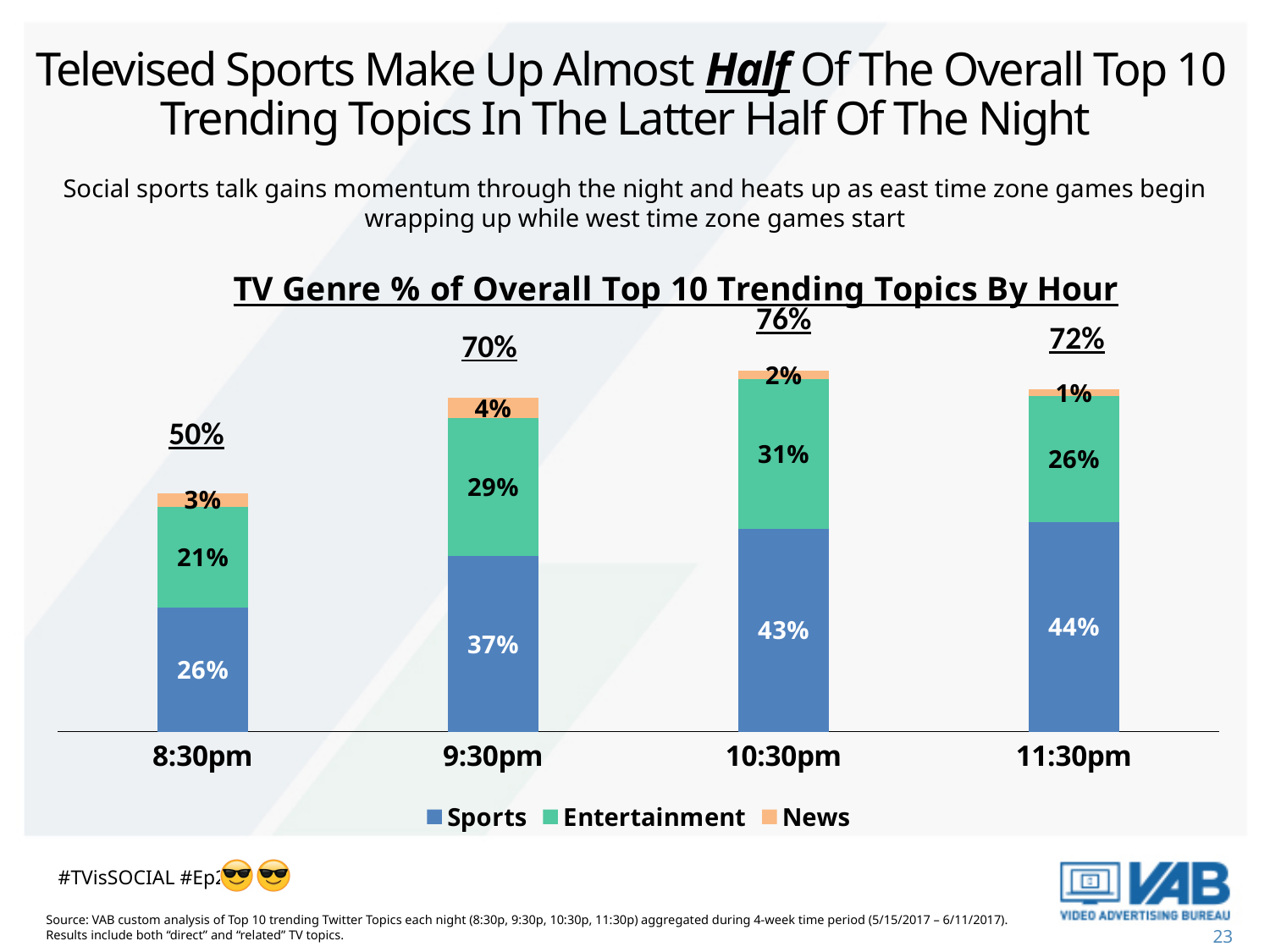
What is the News value at 8:30pm? 3% What is the total of the stacked bar at 10:30pm? 76% Which is larger, the Entertainment value at 9:30pm or at 11:30pm? 9:30pm Does the Sports value rise or fall from 8:30pm to 11:30pm? Rise At which hour is the News value lowest? 11:30pm What is the difference between the Sports values at 11:30pm and 8:30pm? 18% What kind of chart is shown? Stacked bar chart At which hour is the Sports value highest? 11:30pm What is the Sports value at 9:30pm? 37% How many hours are shown on the x axis? 4 What is the Entertainment value at 10:30pm? 31% How many series does the legend list? 3